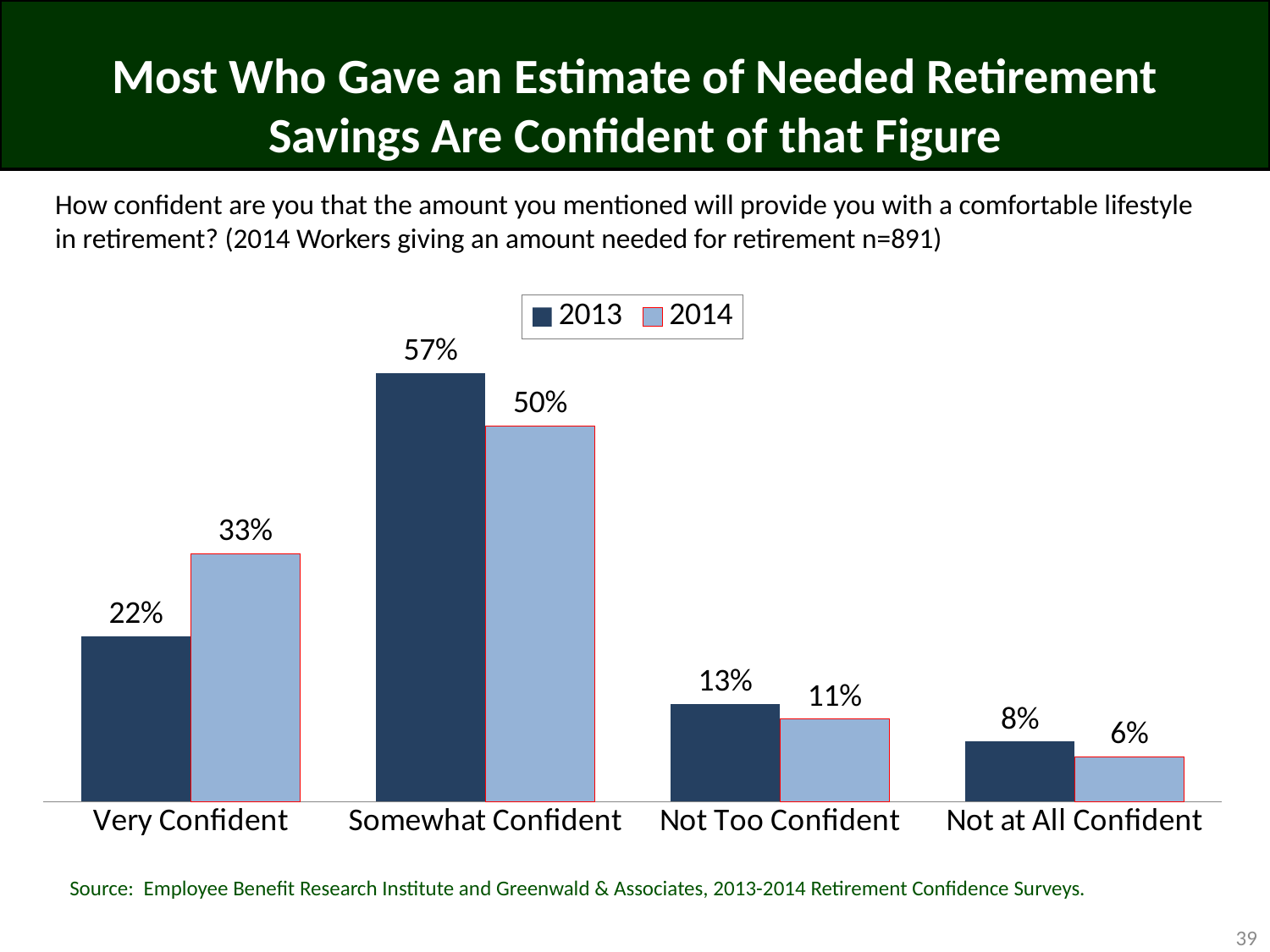
How many categories are shown on the x axis? 4 Which category has the lowest 2013 value? Not at All Confident What is the difference between the 2014 and 2013 values for Very Confident? 11% What is the difference between the 2013 and 2014 values for Somewhat Confident? 7% What is the 2013 value for Not at All Confident? 8% Which is larger for Very Confident, the 2013 value or the 2014 value? 2014 What is the 2013 value for Somewhat Confident? 57% What is the 2014 value for Very Confident? 33% Which category has the highest 2014 value? Somewhat Confident How many series does the legend list? 2 What kind of chart is shown on the slide? Bar chart What is the 2014 value for Not Too Confident? 11%